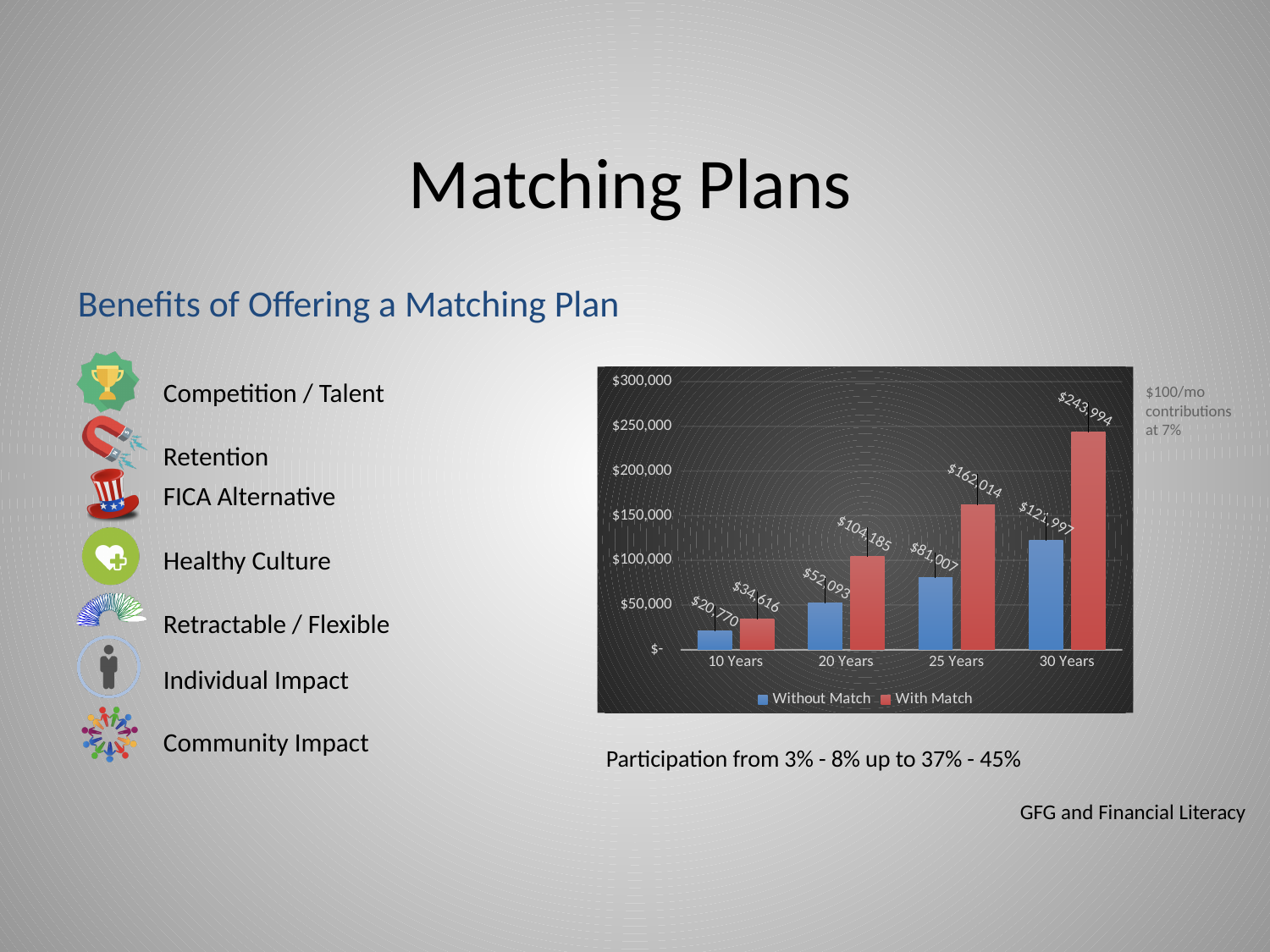
Is the value for With Match at 25 Years greater or less than $150,000? greater How many categories are shown on the x axis? 4 What is the value for With Match at 20 Years? $104,185 Which is larger at 20 Years, Without Match or With Match? With Match What is the value for With Match at 30 Years? $243,994 What is the difference between With Match and Without Match at 25 Years? $81,007 What is the value for Without Match at 10 Years? $20,770 Which category has the highest With Match value? 30 Years What kind of chart is shown on the slide? bar chart What is the value for Without Match at 25 Years? $81,007 How many series does the legend list? 2 Which category has the lowest Without Match value? 10 Years